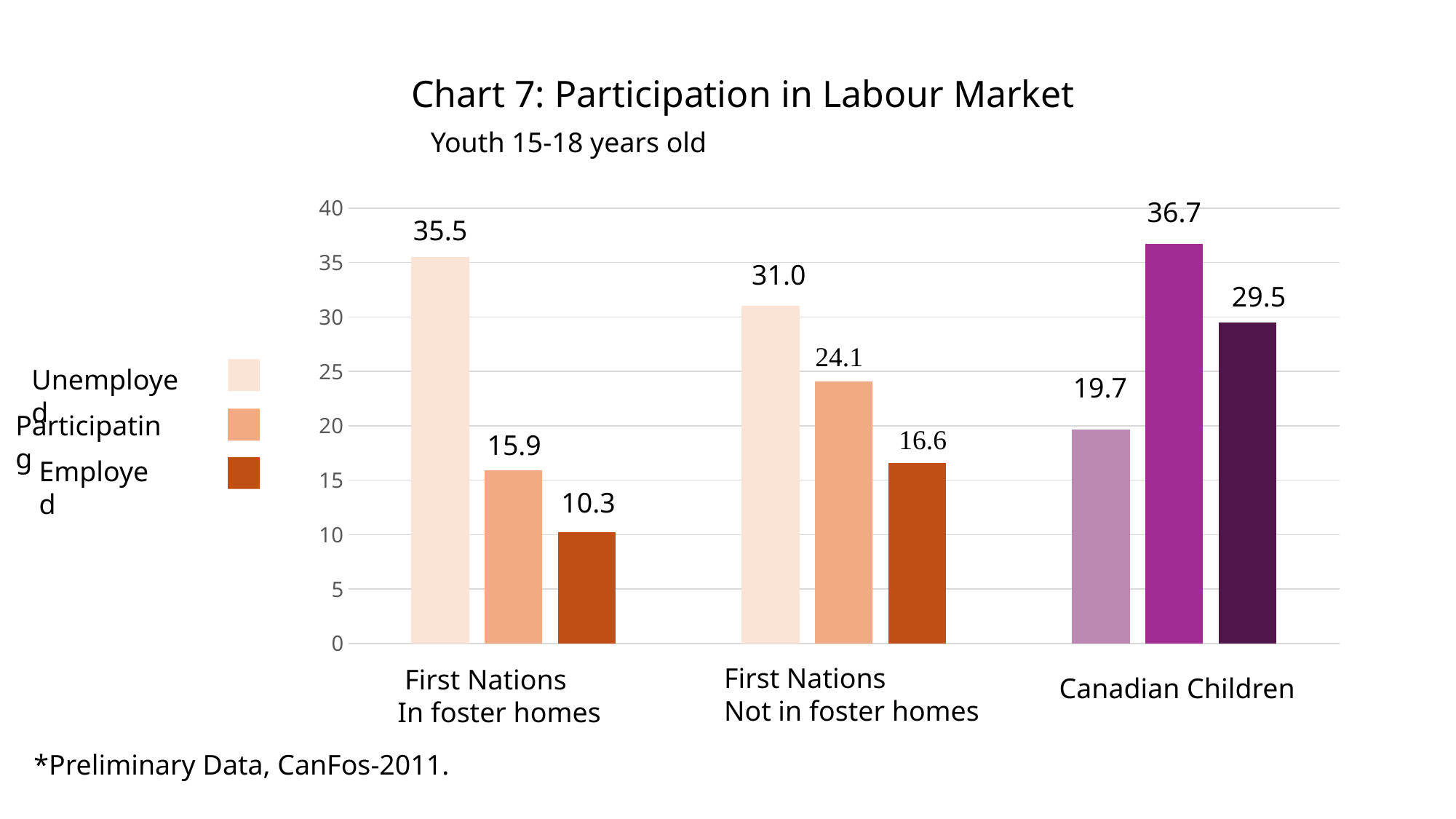
Which is larger: the Participating value for First Nations youth in foster homes or not in foster homes? Not in foster homes What is the title of the chart? Chart 7: Participation in Labour Market What is the difference between the Employed values for First Nations youth not in foster homes and in foster homes? 6.3 What kind of chart is shown on the slide? Bar chart How many series does the legend list? 3 Which series has the lowest value for First Nations youth in foster homes? Employed What is the Participating value for First Nations youth in foster homes? 15.9 What is the Employed value for First Nations youth not in foster homes? 16.6 How many category groups are shown on the x axis? 3 What is the Unemployed value for First Nations youth in foster homes? 35.5 What is the value of the tallest bar in the Canadian Children group? 36.7 What is the difference between the Unemployed values for First Nations youth in foster homes and not in foster homes? 4.5